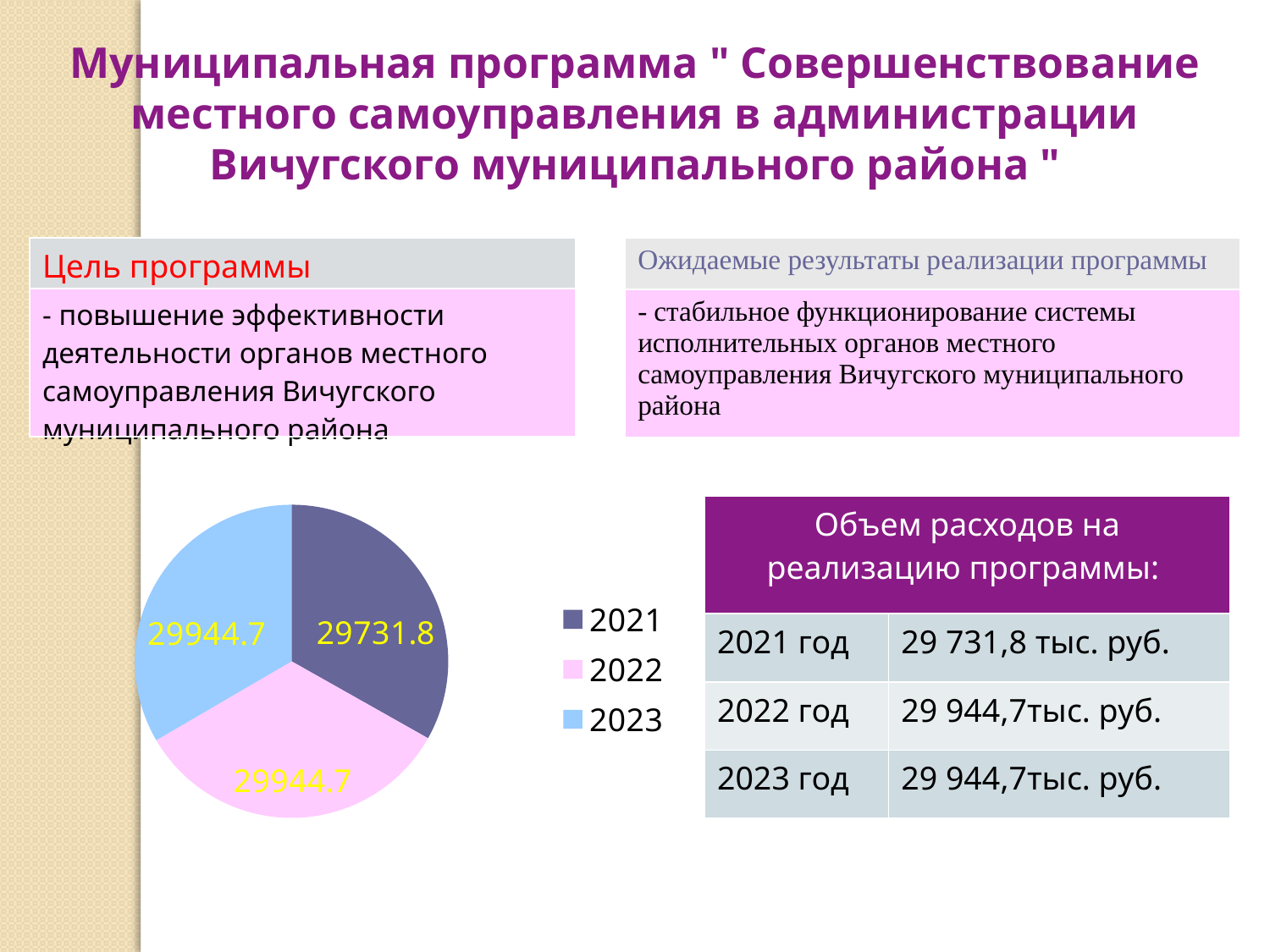
What value is shown for the 2021 slice of the pie chart? 29731.8 Which is larger in the pie chart, the value for 2021 or the value for 2022? 2022 What value is shown for the 2023 slice of the pie chart? 29944.7 What type of chart is shown on the slide? Pie chart How many slices does the pie chart have? 3 What is the difference between the 2022 value and the 2021 value in the pie chart? 212.9 What colour is the 2022 slice in the pie chart? Pink What value is shown for the 2022 slice of the pie chart? 29944.7 Which years are listed in the legend of the pie chart? 2021, 2022, 2023 What is the total of all three slices in the pie chart? 89621.2 How many entries does the legend of the pie chart list? 3 Which year has the smallest slice in the pie chart? 2021